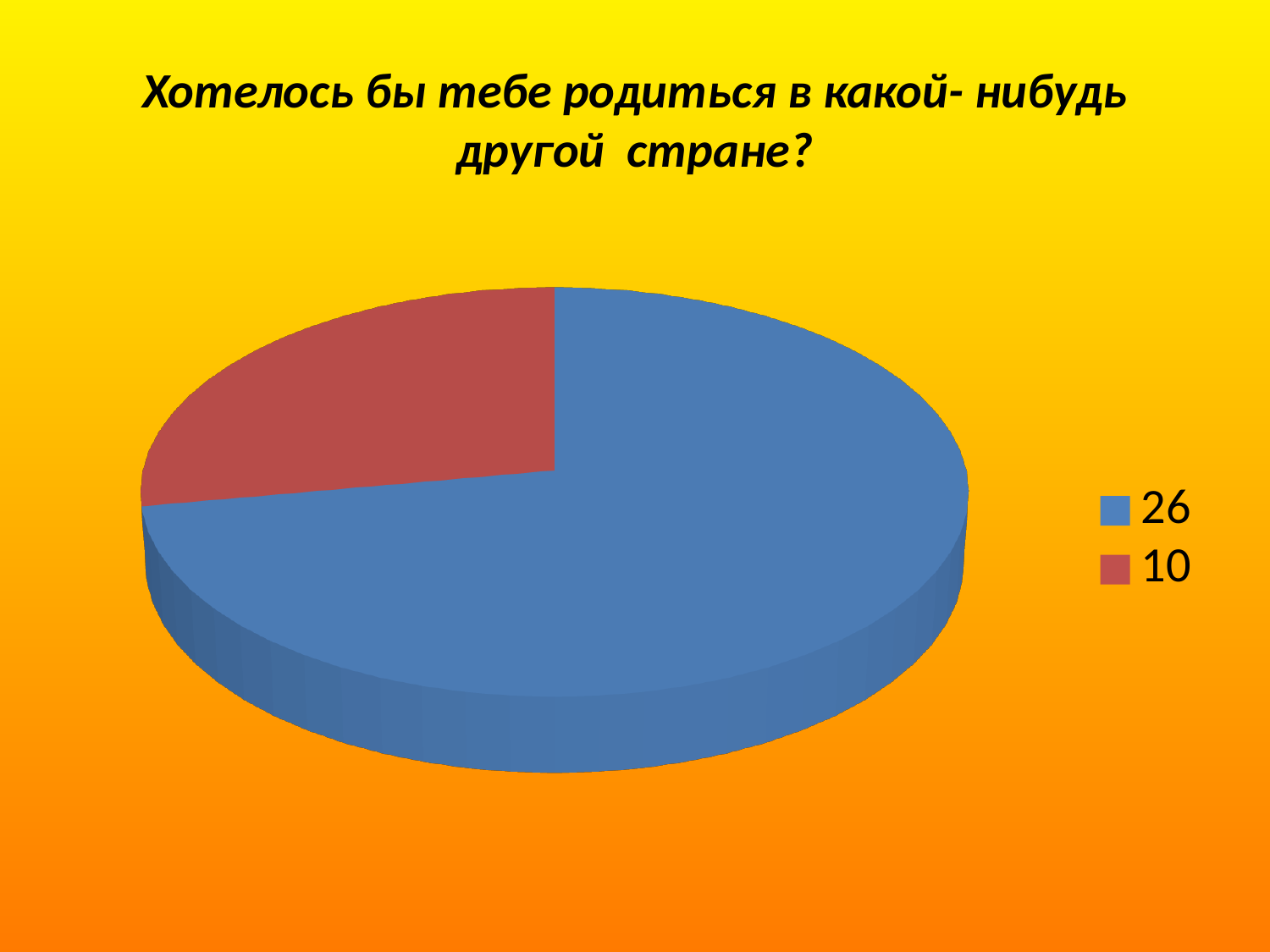
How many entries does the legend list? 2 What label does the legend give to the red slice? 10 What colour is the slice labelled 10 in the legend? red Which legend entry corresponds to the smallest slice of the pie? 10 What label does the legend give to the blue slice? 26 What is the title of the chart? Хотелось бы тебе родиться в какой- нибудь другой стране? What kind of chart is shown on the slide? pie chart How many slices does the pie chart have? 2 Which legend entry corresponds to the largest slice of the pie? 26 What is the difference between the two values shown in the legend, 26 and 10? 16 Which slice of the pie is larger, the blue one or the red one? blue